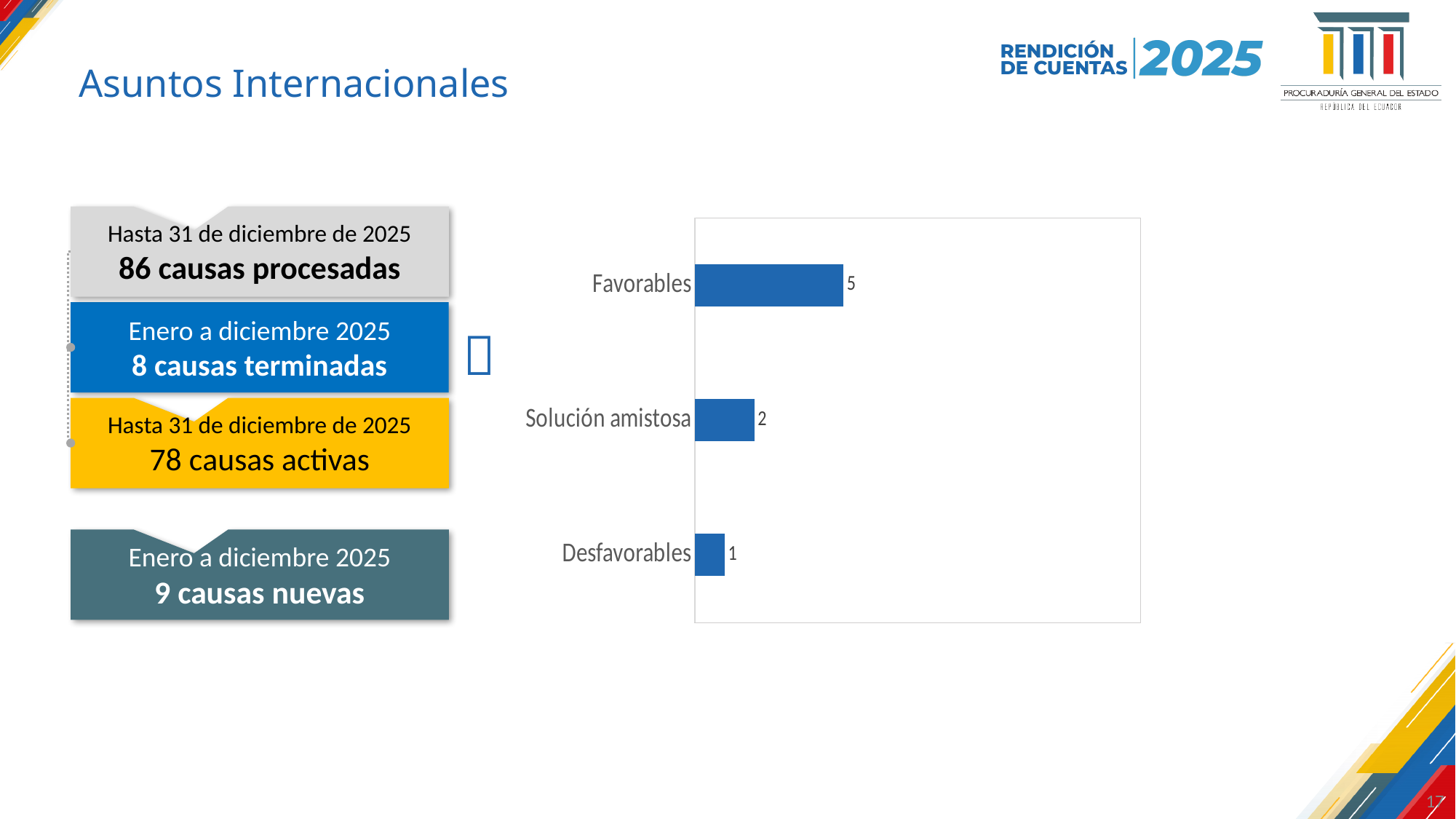
What is the value for Solución amistosa? 2 What is the difference between the values for Favorables and Solución amistosa? 3 What colour are the bars in the chart? Blue What is the difference between the values for Favorables and Desfavorables? 4 What is the total of the three values shown in the chart? 8 Which category has the highest value? Favorables What is the value for Desfavorables? 1 What is the value for Favorables? 5 Which category has the lowest value? Desfavorables Which is larger, the value for Solución amistosa or the value for Desfavorables? Solución amistosa What kind of chart is shown on the slide? Bar chart How many categories are shown in the chart? 3